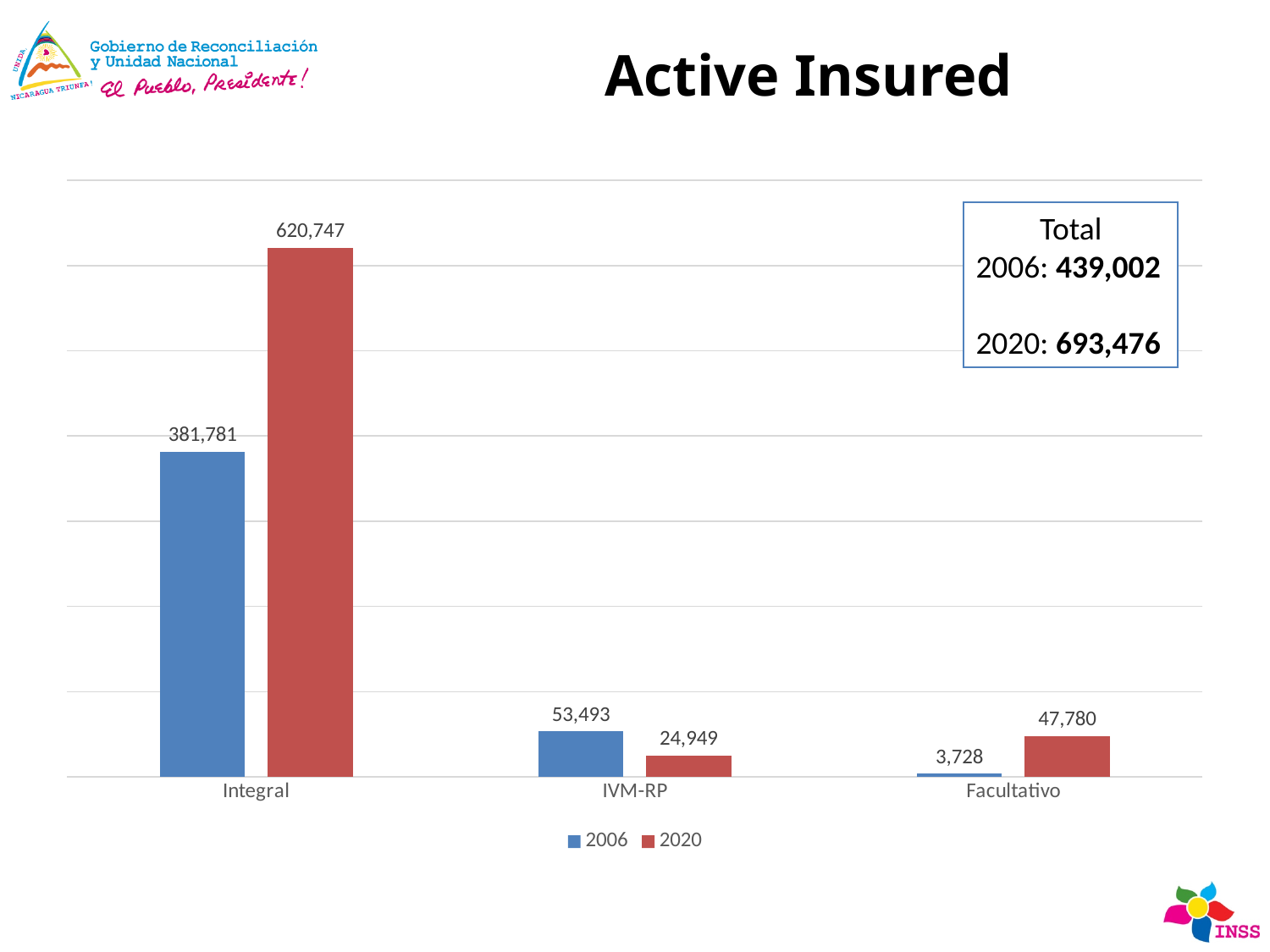
Which category has the lowest value in 2006? Facultativo What is the difference between the 2020 and 2006 values for Integral? 238,966 What is the value for Facultativo in 2020? 47,780 Which is larger for IVM-RP, the 2006 value or the 2020 value? 2006 What is the total for 2020 shown in the box on the slide? 693,476 What is the value for Integral in 2020? 620,747 What kind of chart is shown on the slide? Bar chart What is the value for IVM-RP in 2006? 53,493 How many series does the legend list? 2 How many categories are shown on the x axis? 3 Which category has the highest value in 2020? Integral What is the value for Integral in 2006? 381,781